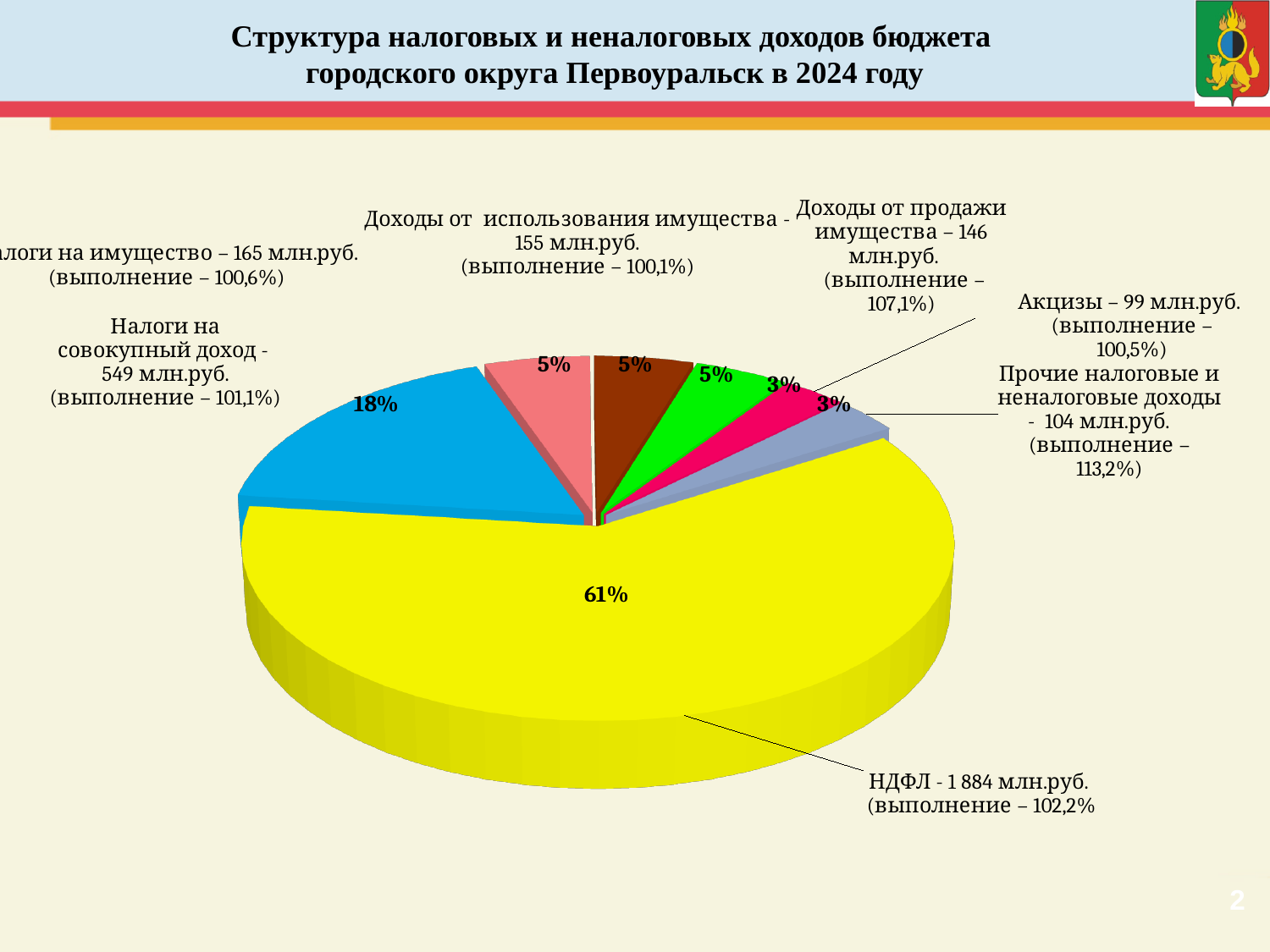
What kind of chart is shown on the slide? pie chart What is the title of the chart on the slide? Структура налоговых и неналоговых доходов бюджета городского округа Первоуральск в 2024 году What share of the pie does НДФЛ account for? 61% What is the value shown for Налоги на совокупный доход? 549 млн.руб. What execution percentage (выполнение) is shown for Прочие налоговые и неналоговые доходы? 113,2% What share of the pie does Налоги на совокупный доход account for? 18% Which category has the smallest value in млн.руб.? Акцизы Which category has the largest slice of the pie? НДФЛ What is the difference between Налоги на имущество (165 млн.руб.) and Доходы от использования имущества (155 млн.руб.)? 10 млн.руб. How many slices (revenue categories) does the pie chart have? 7 What is the value shown for НДФЛ? 1 884 млн.руб. Which is larger: Акцизы or Прочие налоговые и неналоговые доходы? Прочие налоговые и неналоговые доходы